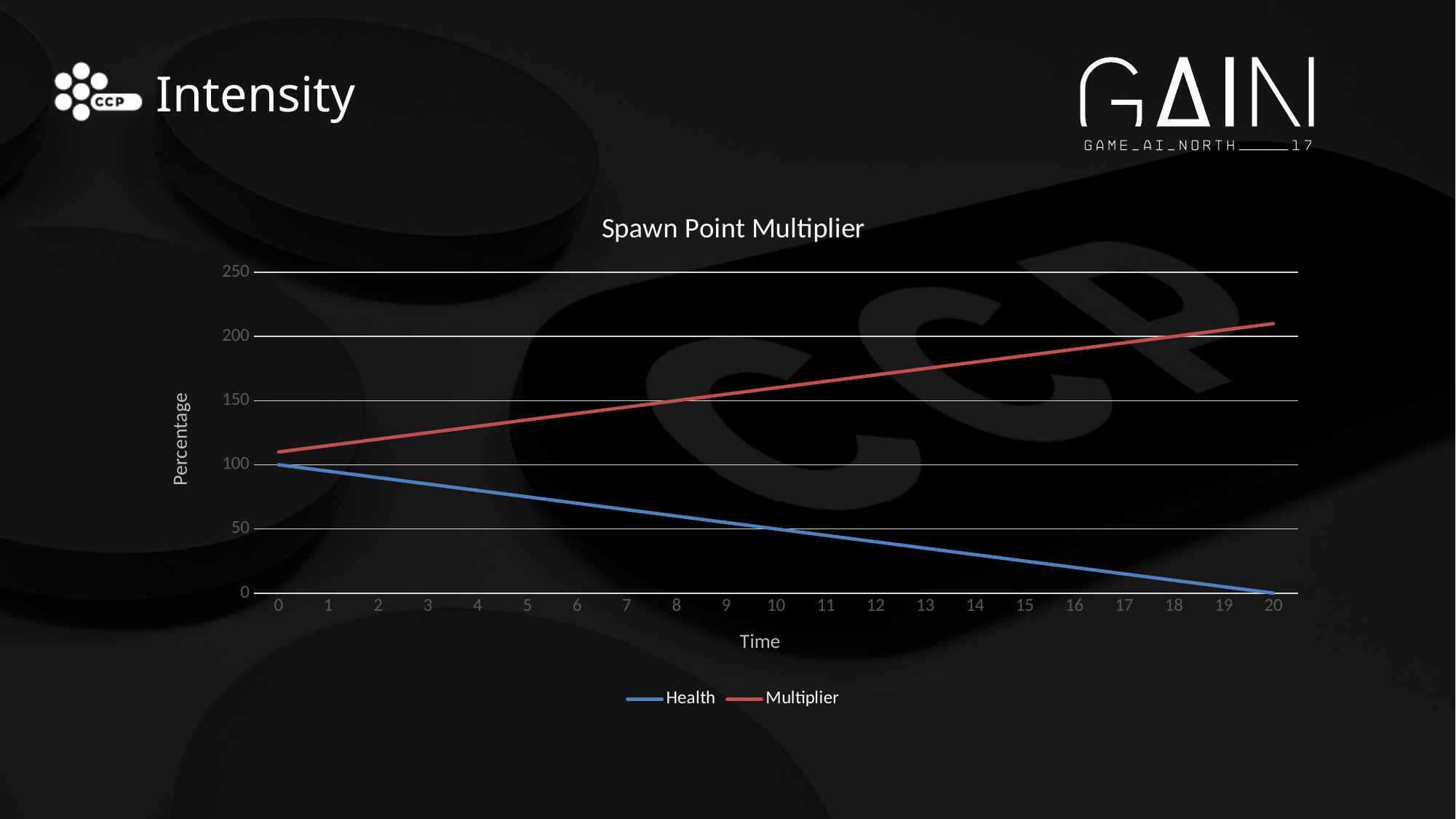
Does the Health line rise or fall as time increases? fall Is the value of Health at time 15 greater or less than 50? less What is the value of Health at time 0? 100 Is the value of Multiplier at time 20 greater or less than 200? greater What is the value of Health at time 10? 50 How many series does the legend list? 2 What is the value of Health at time 20? 0 Is the value of Multiplier at time 10 greater or less than 150? greater What kind of chart is shown on the slide? line chart Does the Multiplier line rise or fall as time increases? rise What is the title of the chart? Spawn Point Multiplier At time 20, which series has the larger value, Health or Multiplier? Multiplier